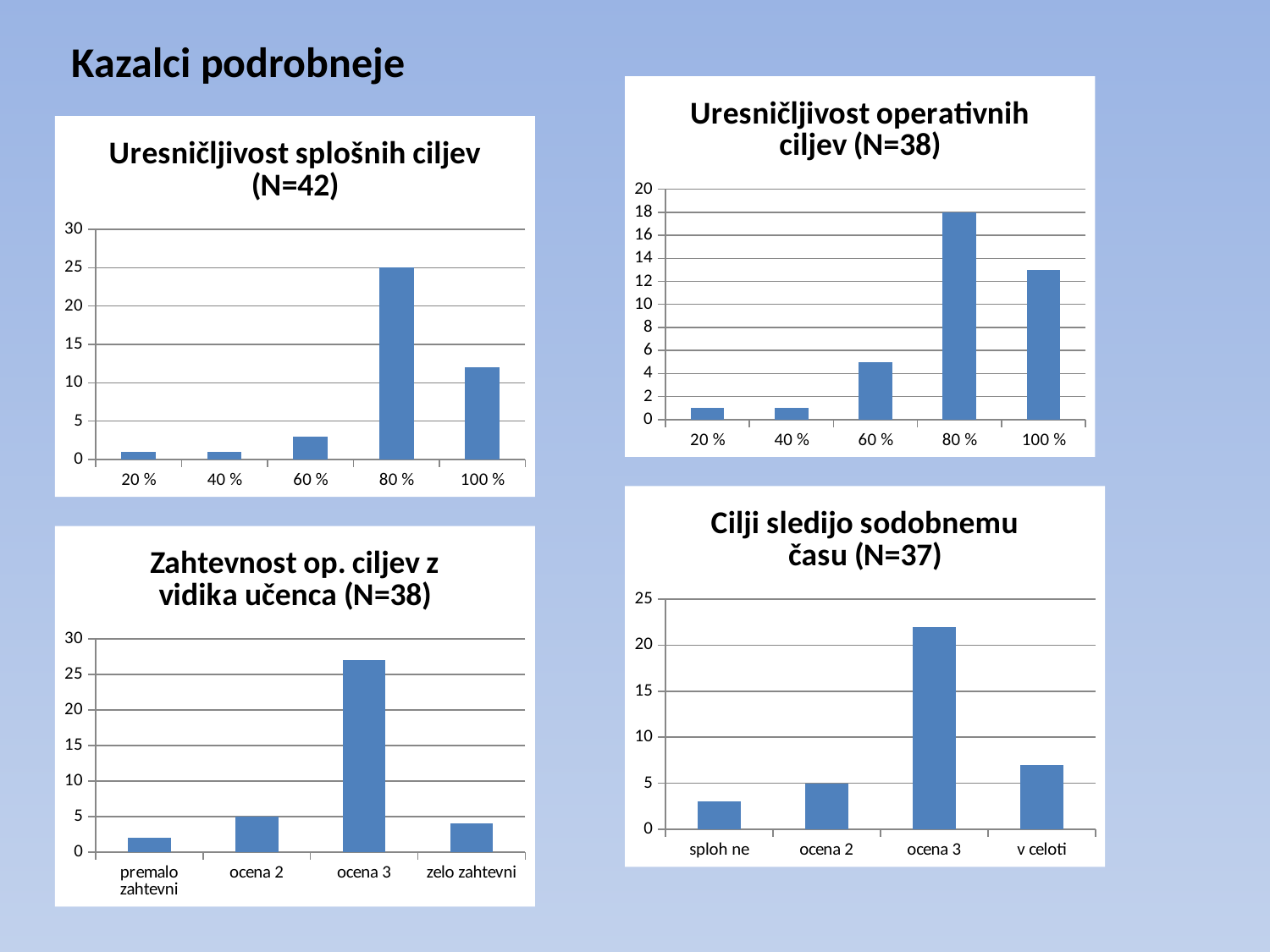
In the chart 'Cilji sledijo sodobnemu času (N=37)', which category has the highest value? ocena 3 In the chart 'Uresničljivost splošnih ciljev (N=42)', which category has the highest value? 80 % In the chart 'Cilji sledijo sodobnemu času (N=37)', is the value for ocena 3 greater or less than 20? greater How many categories are shown in the chart 'Zahtevnost op. ciljev z vidika učenca (N=38)'? 4 In the chart 'Uresničljivost splošnih ciljev (N=42)', which is larger, the value for 100 % or the value for 60 %? 100 % In the chart 'Zahtevnost op. ciljev z vidika učenca (N=38)', what is the value for ocena 2? 5 In the chart 'Cilji sledijo sodobnemu času (N=37)', what is the value for ocena 2? 5 What kind of chart is 'Uresničljivost operativnih ciljev (N=38)'? Bar chart In the chart 'Uresničljivost operativnih ciljev (N=38)', what is the value for 80 %? 18 In the chart 'Uresničljivost operativnih ciljev (N=38)', is the value for 100 % greater or less than 10? greater In the chart 'Zahtevnost op. ciljev z vidika učenca (N=38)', which category has the lowest value? premalo zahtevni In the chart 'Uresničljivost splošnih ciljev (N=42)', what is the value for 80 %? 25